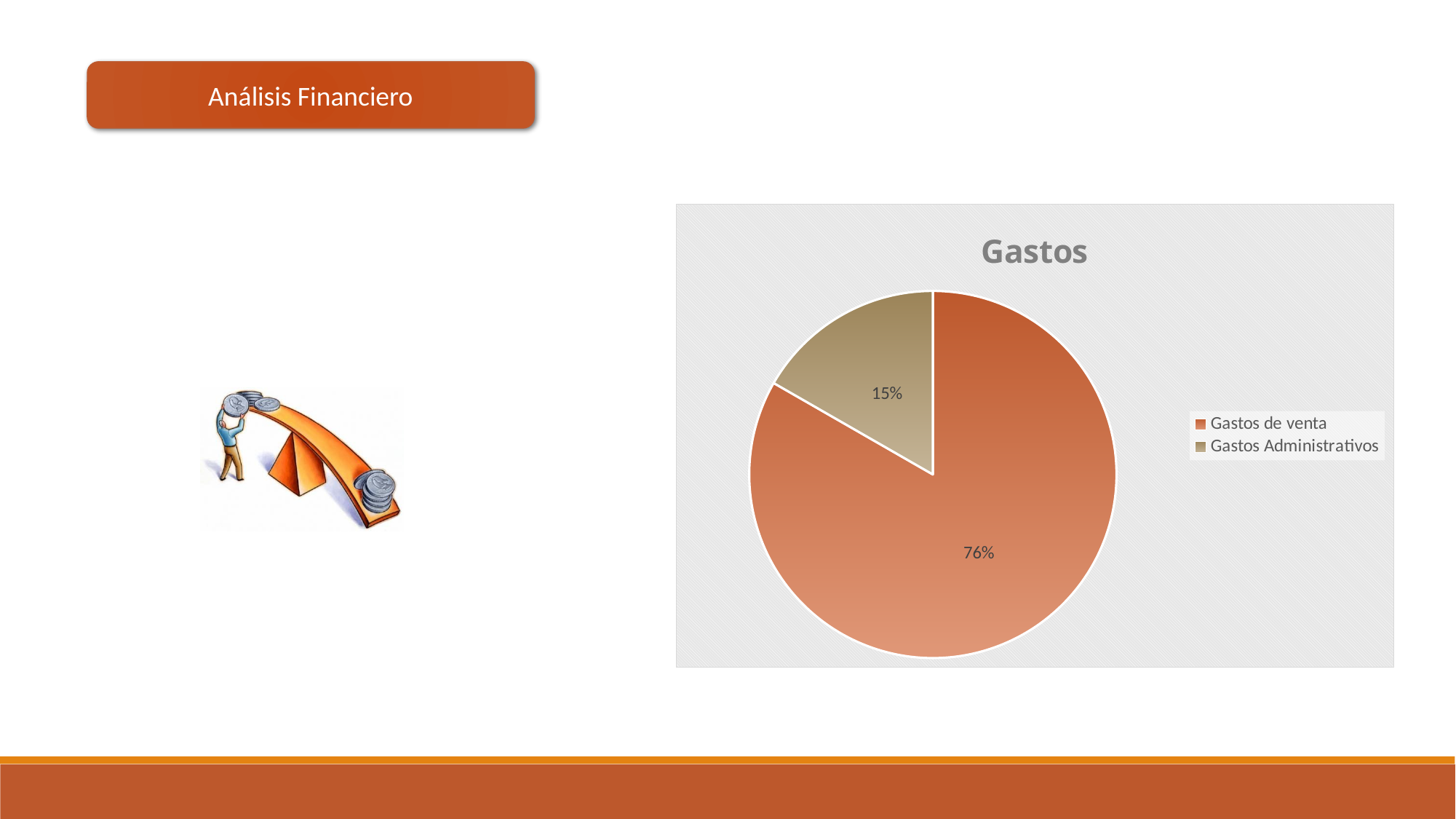
How many entries does the legend list? 2 What is the difference in percentage points between Gastos de venta and Gastos Administrativos? 61 What kind of chart is shown on the slide? pie chart Which category has the smallest slice of the pie? Gastos Administrativos Which category has the largest slice of the pie? Gastos de venta Which legend entry is shown in orange? Gastos de venta Which is larger, Gastos de venta or Gastos Administrativos? Gastos de venta What percentage is shown for Gastos Administrativos? 15% How many slices does the pie chart have? 2 What is the title of the chart? Gastos What share of the pie does Gastos Administrativos represent? 15% What percentage is shown for Gastos de venta? 76%